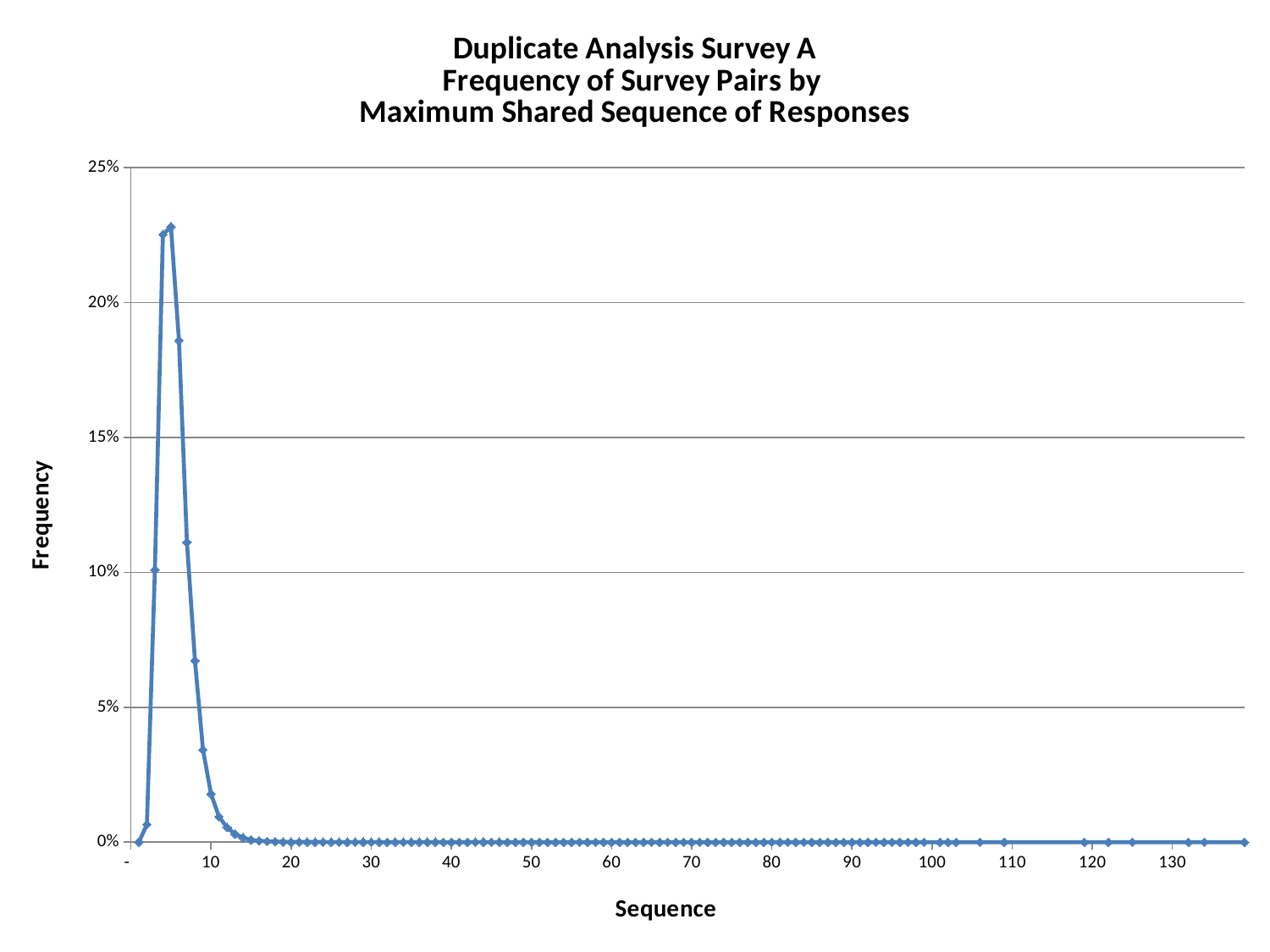
Is the value at sequence 10 greater or less than 5%? less Is the peak of the line located before or after sequence 10 on the x axis? before What is the label of the x axis? Sequence What kind of chart is shown on the slide? line chart Is the value at sequence 100 greater or less than 5%? less What is the label of the y axis? Frequency Is the highest value on the chart greater or less than 25%? less After the peak, do the values rise or fall as the sequence increases? fall